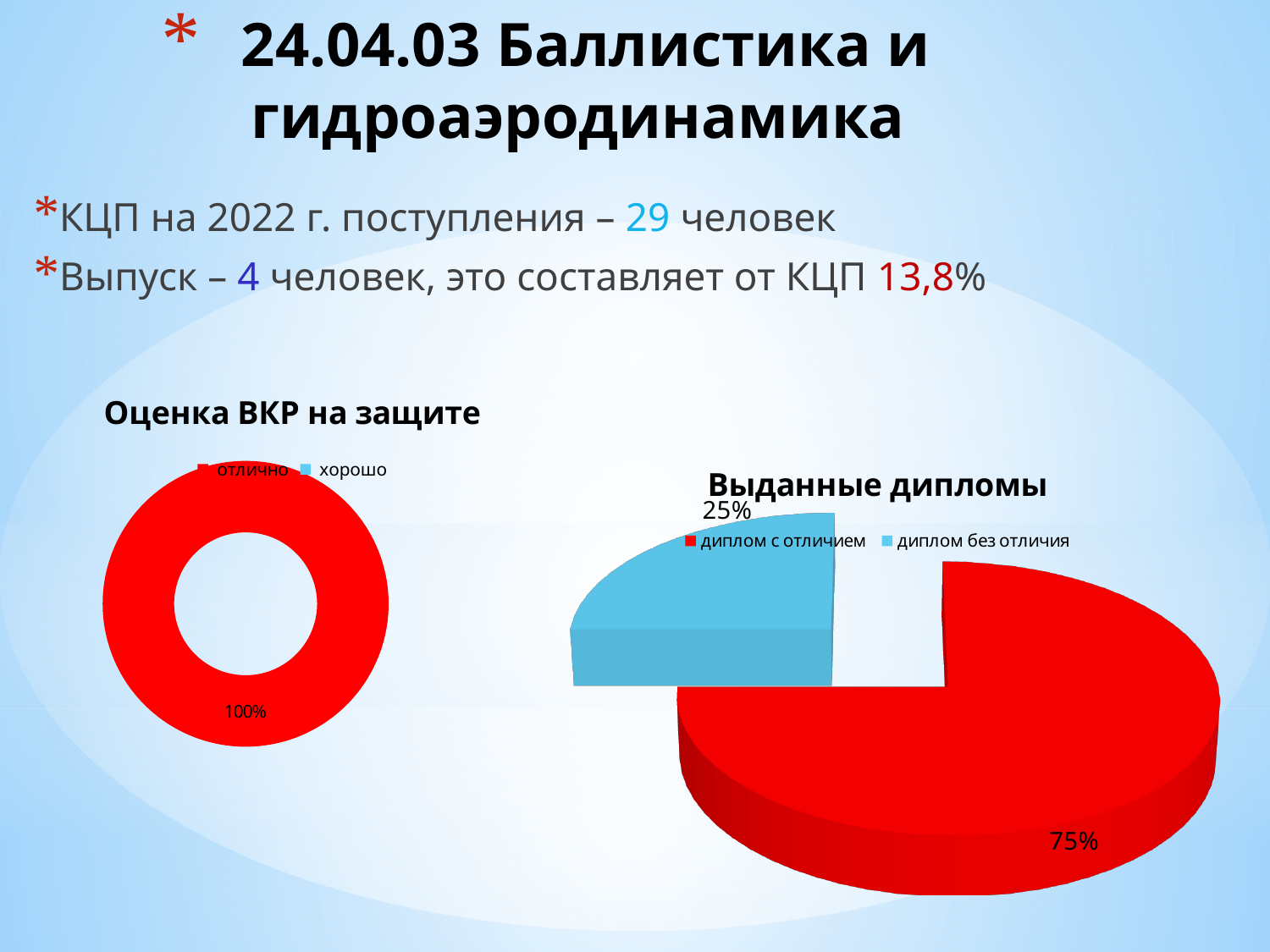
In the chart "Выданные дипломы", which category has the smallest slice? диплом без отличия How many slices does the chart "Выданные дипломы" show? 2 What kind of chart is "Оценка ВКР на защите"? doughnut chart In the chart "Выданные дипломы", what is the difference in percentage points between "диплом с отличием" and "диплом без отличия"? 50 In the chart titled "Оценка ВКР на защите", what share is labelled for "отлично"? 100% What kind of chart is "Выданные дипломы"? pie chart In the chart "Выданные дипломы", what share is labelled for "диплом без отличия"? 25% In the chart "Выданные дипломы", which is larger: "диплом с отличием" or "диплом без отличия"? диплом с отличием In the chart "Выданные дипломы", what share is labelled for "диплом с отличием"? 75% In the chart "Выданные дипломы", what colour is the slice for "диплом без отличия"? light blue In the chart "Выданные дипломы", which category has the largest slice? диплом с отличием How many entries does the legend of the chart "Оценка ВКР на защите" list? 2